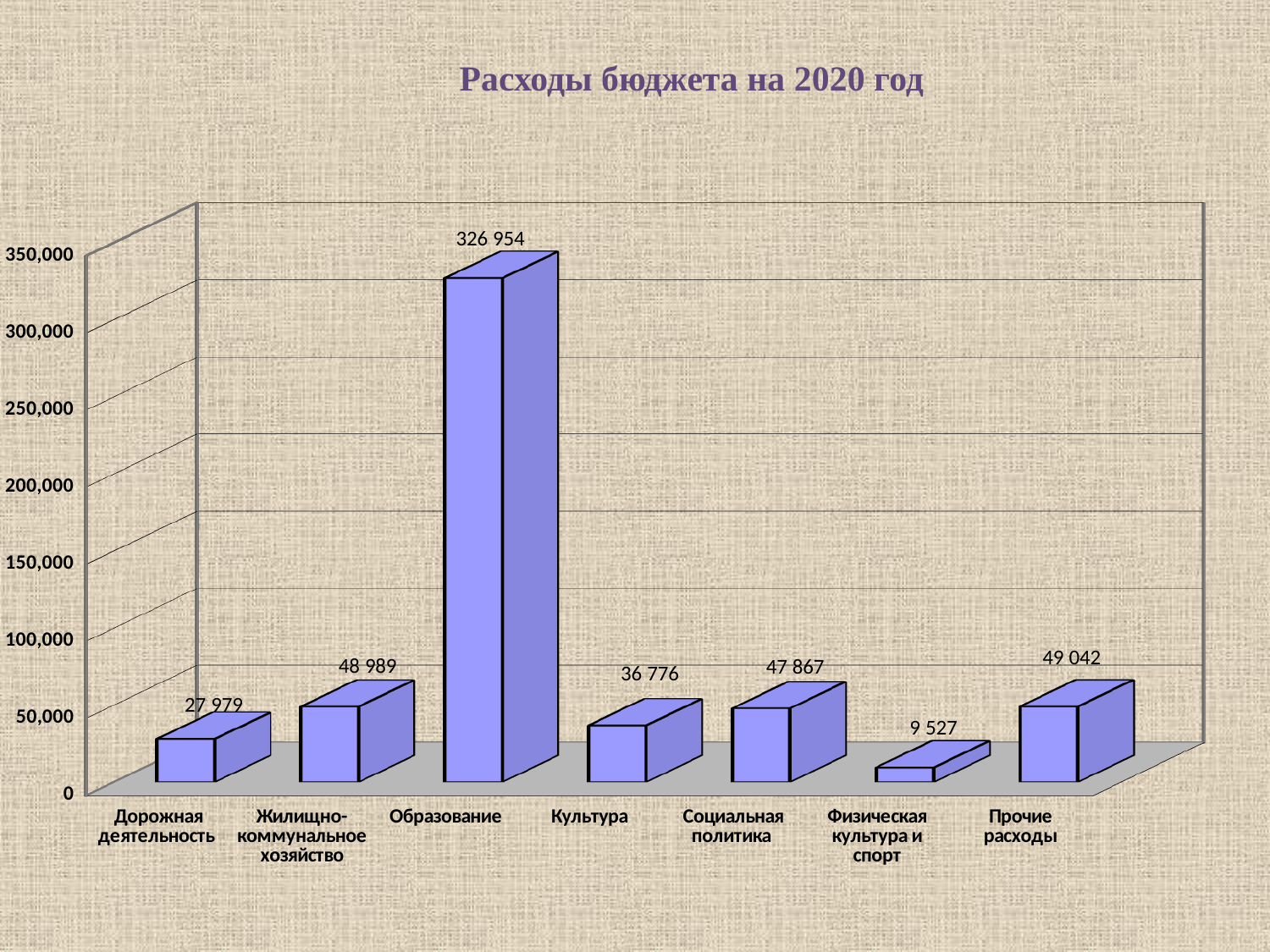
What is the title of the chart? Расходы бюджета на 2020 год Which category has the highest value? Образование Which category has the lowest value? Физическая культура и спорт What is the difference between the values for Образование and Жилищно-коммунальное хозяйство? 277 965 What is the value for Физическая культура и спорт? 9 527 How many categories are shown on the chart? 7 What is the value for Дорожная деятельность? 27 979 Is the value for Образование greater or less than 300,000? greater What is the value for Образование? 326 954 What is the difference between the values for Социальная политика and Культура? 11 091 What is the value for Социальная политика? 47 867 Which is larger, the value for Культура or the value for Социальная политика? Социальная политика